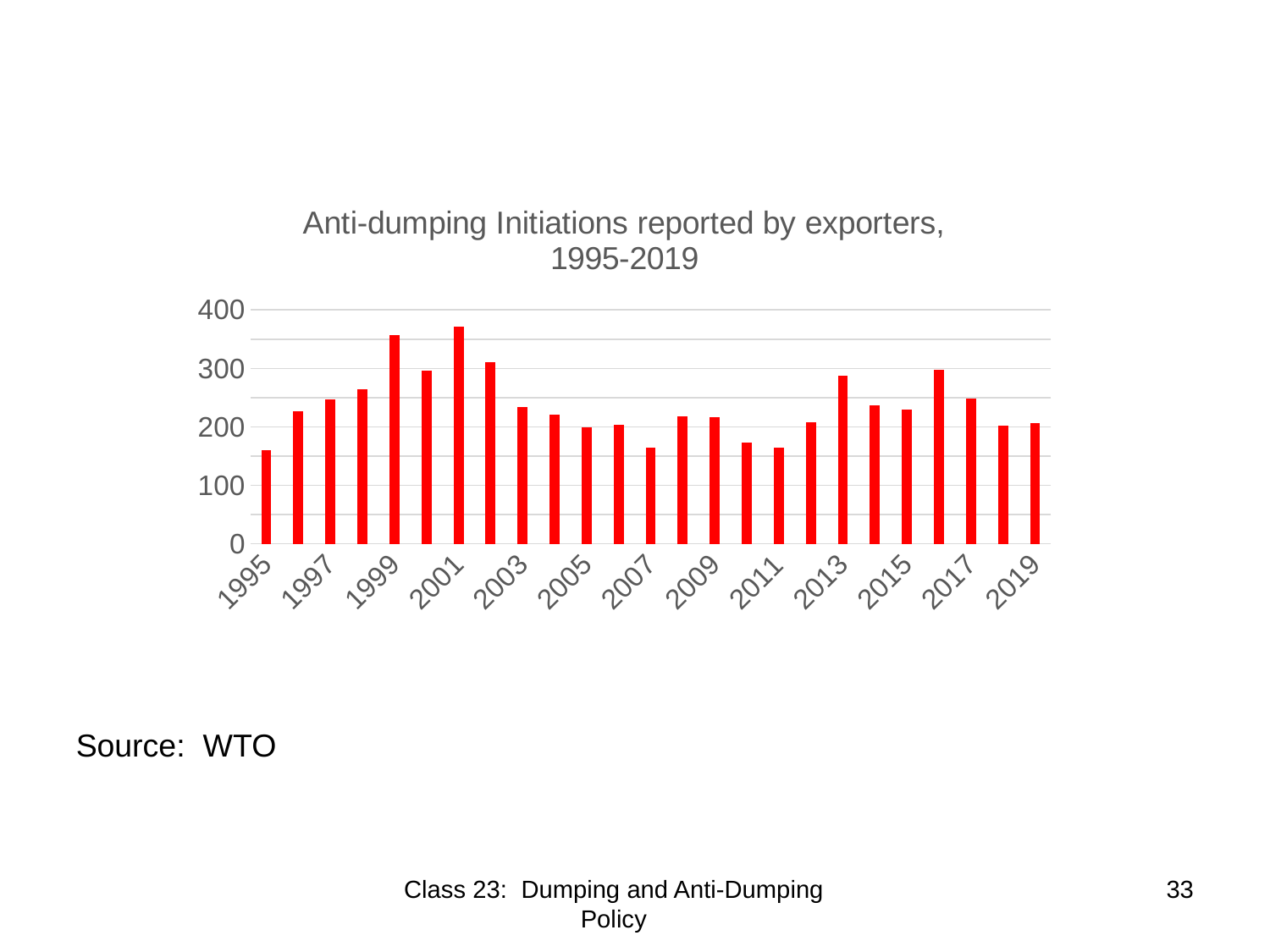
Which year has the highest number of anti-dumping initiations? 2001 Is the value for 1999 greater or less than 300? greater Do the values rise or fall from 1995 to 2001? rise What is the title of the chart? Anti-dumping Initiations reported by exporters, 1995-2019 Is the value for 2013 greater or less than 200? greater Is the value for 2011 greater or less than 200? less How many bars (years) are plotted in the chart? 25 Which year has the larger value, 2001 or 2011? 2001 What colour are the bars in the chart? red What kind of chart is shown on the slide? bar chart